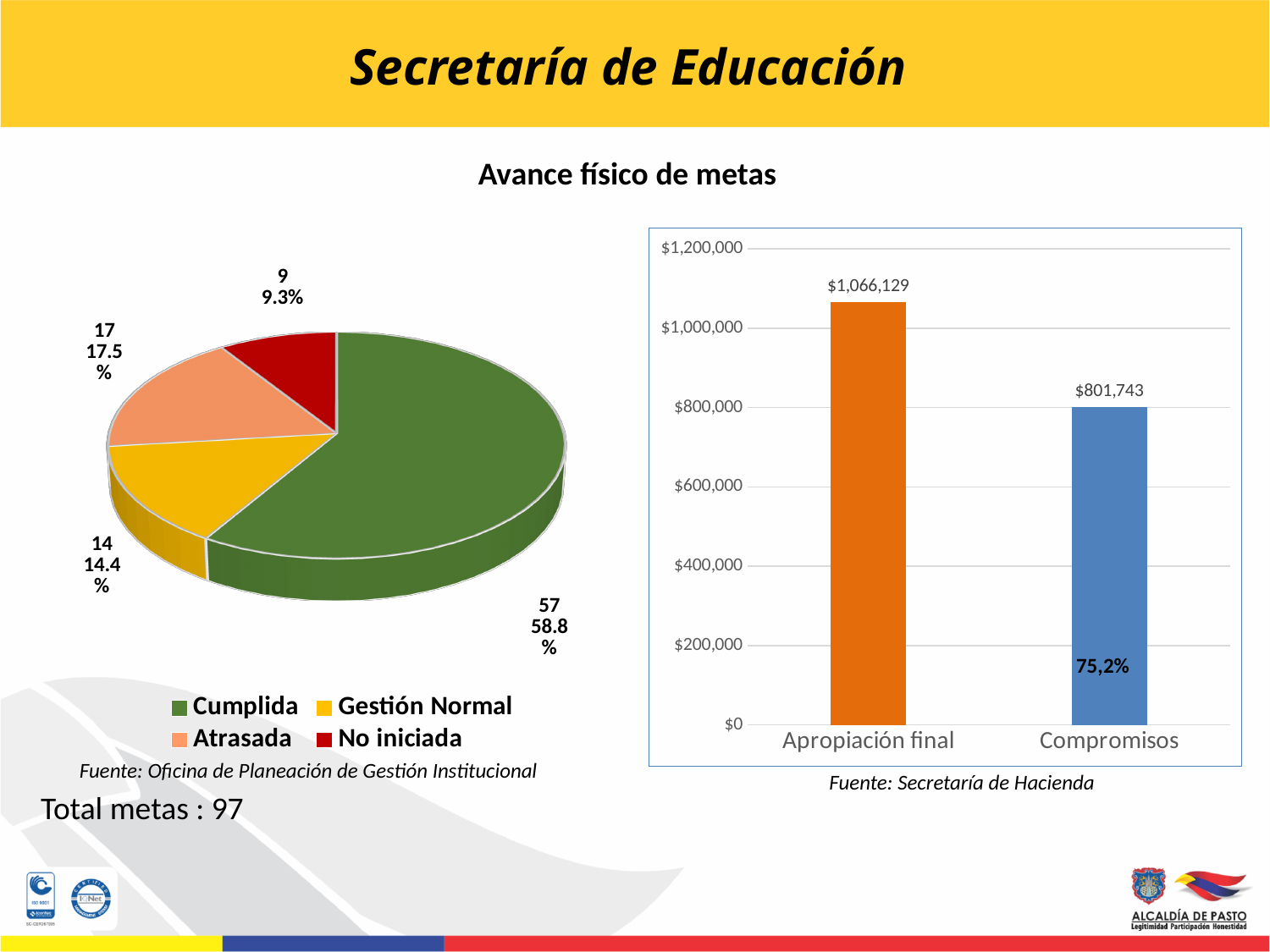
In the pie chart on the left, how many metas are labelled Atrasada? 17 In the bar chart on the right, what is the value for Apropiación final? $1,066,129 In the pie chart on the left, which is larger, Gestión Normal or Atrasada? Atrasada In the pie chart on the left, how many metas are labelled Cumplida? 57 In the pie chart on the left, what percentage share does the No iniciada slice have? 9.3% In the bar chart on the right, what is the value for Compromisos? $801,743 In the pie chart on the left, what percentage share does the Cumplida slice have? 58.8% In the pie chart on the left, which category has the largest slice? Cumplida In the pie chart on the left, how many categories does the legend list? 4 In the bar chart on the right, what is the difference between Apropiación final and Compromisos? $264,386 What kind of chart is shown on the right side of the slide? Bar chart In the pie chart on the left, which category has the smallest slice? No iniciada